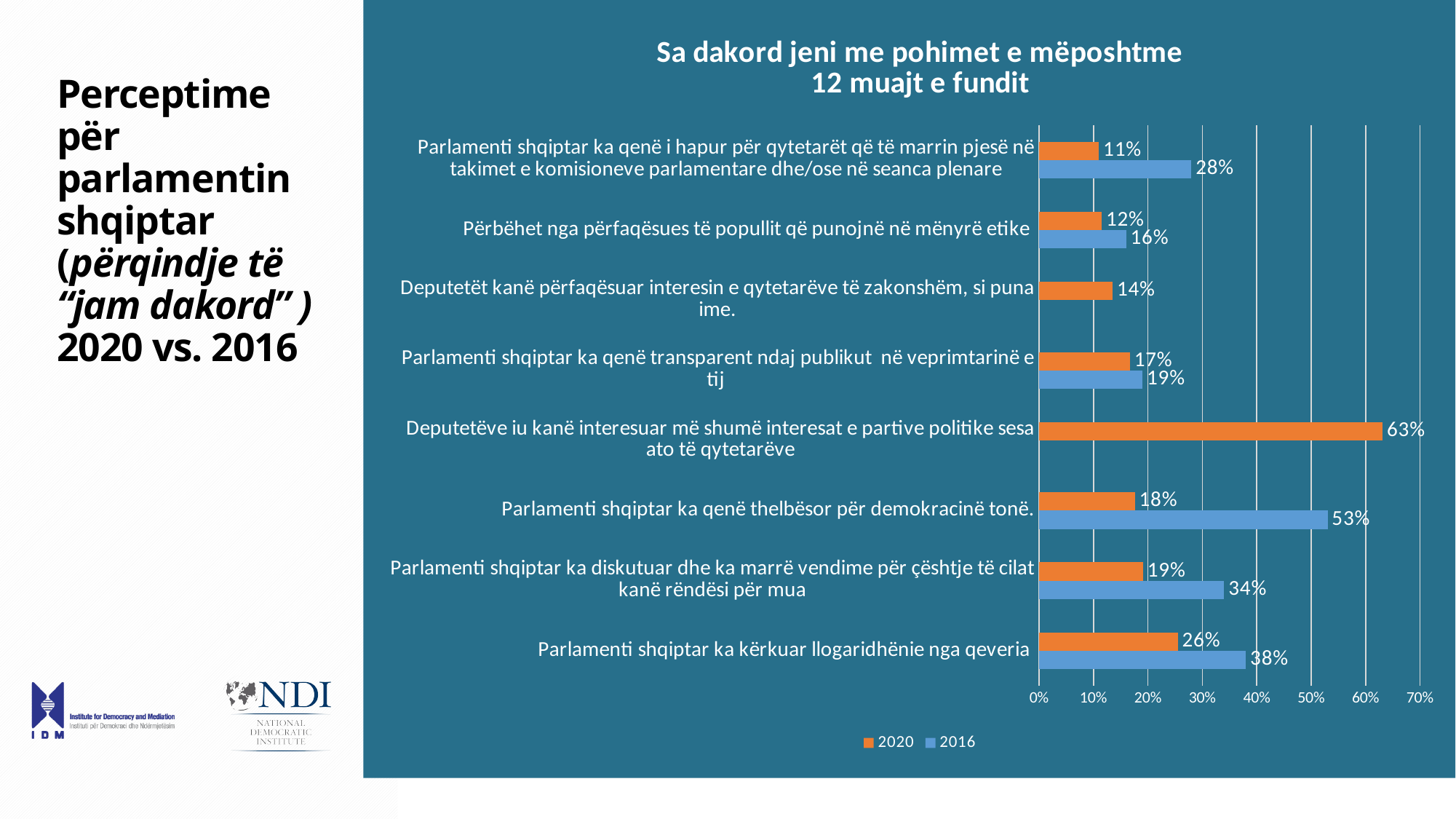
For "Parlamenti shqiptar ka diskutuar dhe ka marrë vendime për çështje të cilat kanë rëndësi për mua", which year has the larger value, 2020 or 2016? 2016 What is the difference between the 2016 and 2020 values for "Parlamenti shqiptar ka qenë i hapur për qytetarët që të marrin pjesë në takimet e komisioneve parlamentare dhe/ose në seanca plenare"? 17% Which statement has the lowest 2020 value? Parlamenti shqiptar ka qenë i hapur për qytetarët që të marrin pjesë në takimet e komisioneve parlamentare dhe/ose në seanca plenare What is the 2020 value for "Parlamenti shqiptar ka kërkuar llogaridhënie nga qeveria"? 26% What type of chart is shown on the slide? bar chart What is the 2016 value for "Parlamenti shqiptar ka qenë thelbësor për demokracinë tonë."? 53% What is the 2020 value for "Deputetëve iu kanë interesuar më shumë interesat e partive politike sesa ato të qytetarëve"? 63% Which statement has the highest 2020 value? Deputetëve iu kanë interesuar më shumë interesat e partive politike sesa ato të qytetarëve How many series does the chart legend list? 2 Which colour represents the 2020 series in the chart? orange What is the difference between the 2016 and 2020 values for "Parlamenti shqiptar ka qenë thelbësor për demokracinë tonë."? 35% How many statements (categories) are shown on the chart? 8